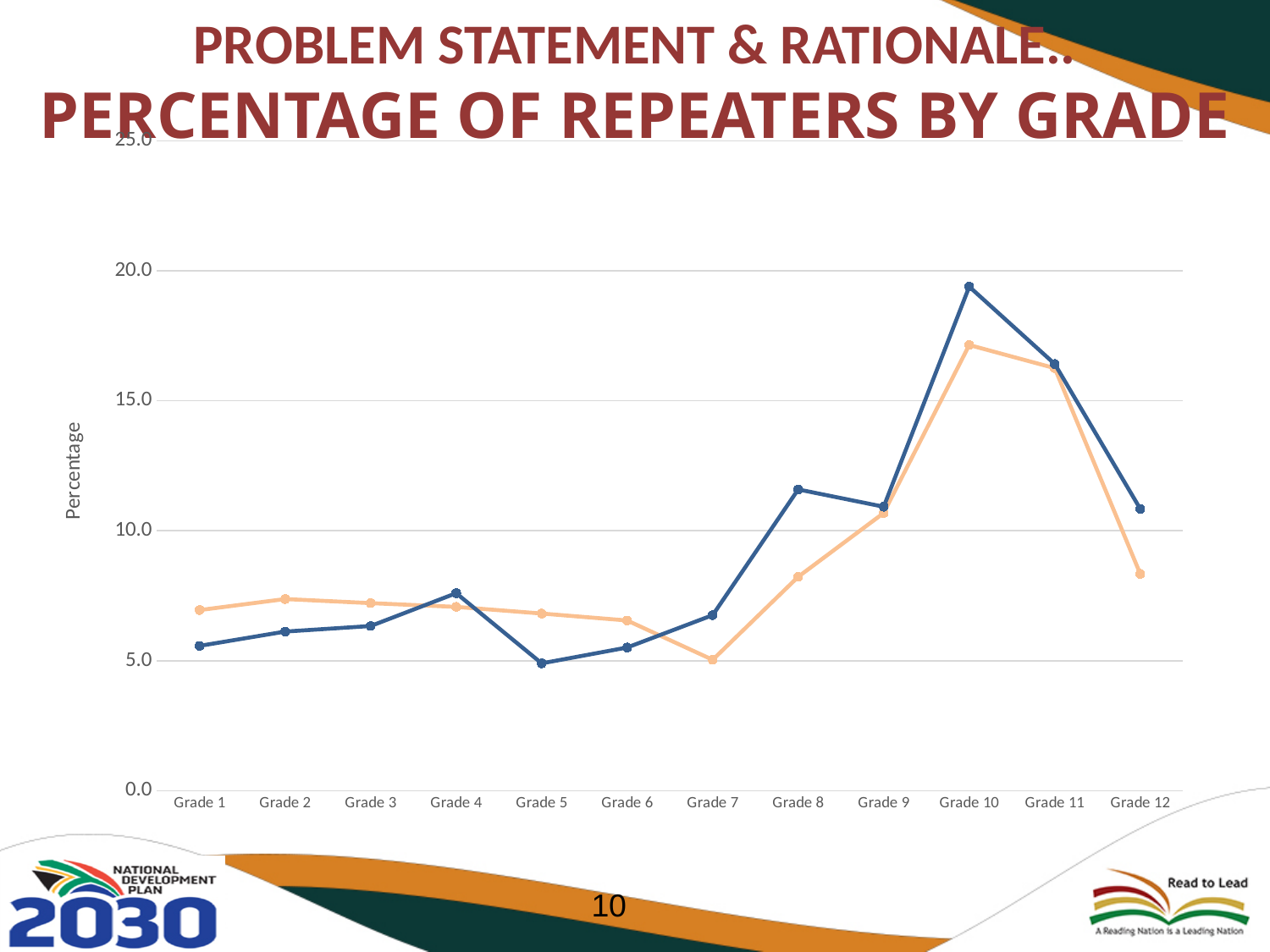
Is the orange line's value for Grade 10 greater or less than 15.0? greater At Grade 8, which line has the higher value, the blue line or the orange line? the blue line For the blue line, which grade has the highest percentage of repeaters? Grade 10 How many grades are shown along the x axis of the chart? 12 At Grade 1, which line has the higher value, the blue line or the orange line? the orange line Is the blue line's value for Grade 10 greater or less than 15.0? greater What is the title of the vertical axis of the chart? Percentage For the orange line, which grade has the highest percentage of repeaters? Grade 10 Is the orange line's value for Grade 12 greater or less than 10.0? less For the blue line, which grade has the lowest percentage of repeaters? Grade 5 What kind of chart is shown on the slide? line chart For the orange line, which grade has the lowest percentage of repeaters? Grade 7